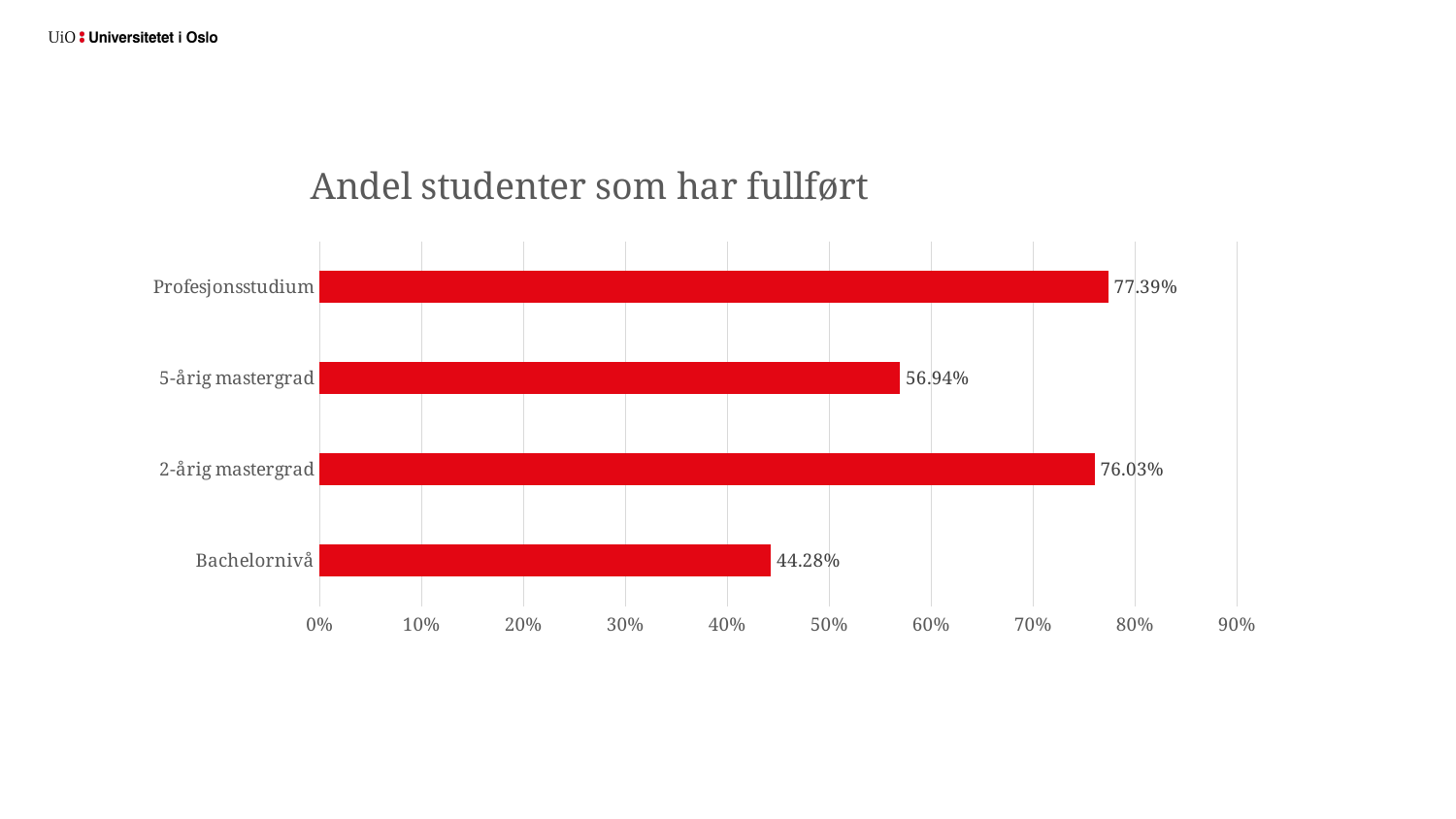
How many categories are shown in the chart? 4 What kind of chart is shown on the slide? Bar chart Which category has the lowest value? Bachelornivå What is the value for Profesjonsstudium? 77.39% Which is larger, the value for 5-årig mastergrad or the value for Bachelornivå? 5-årig mastergrad What is the value for 5-årig mastergrad? 56.94% Which category has the highest value? Profesjonsstudium What is the difference between the values for Profesjonsstudium and Bachelornivå? 33.11 percentage points What is the value for 2-årig mastergrad? 76.03% What is the difference between the values for 2-årig mastergrad and 5-årig mastergrad? 19.09 percentage points Is the value for 5-årig mastergrad greater or less than 50%? greater What is the value for Bachelornivå? 44.28%